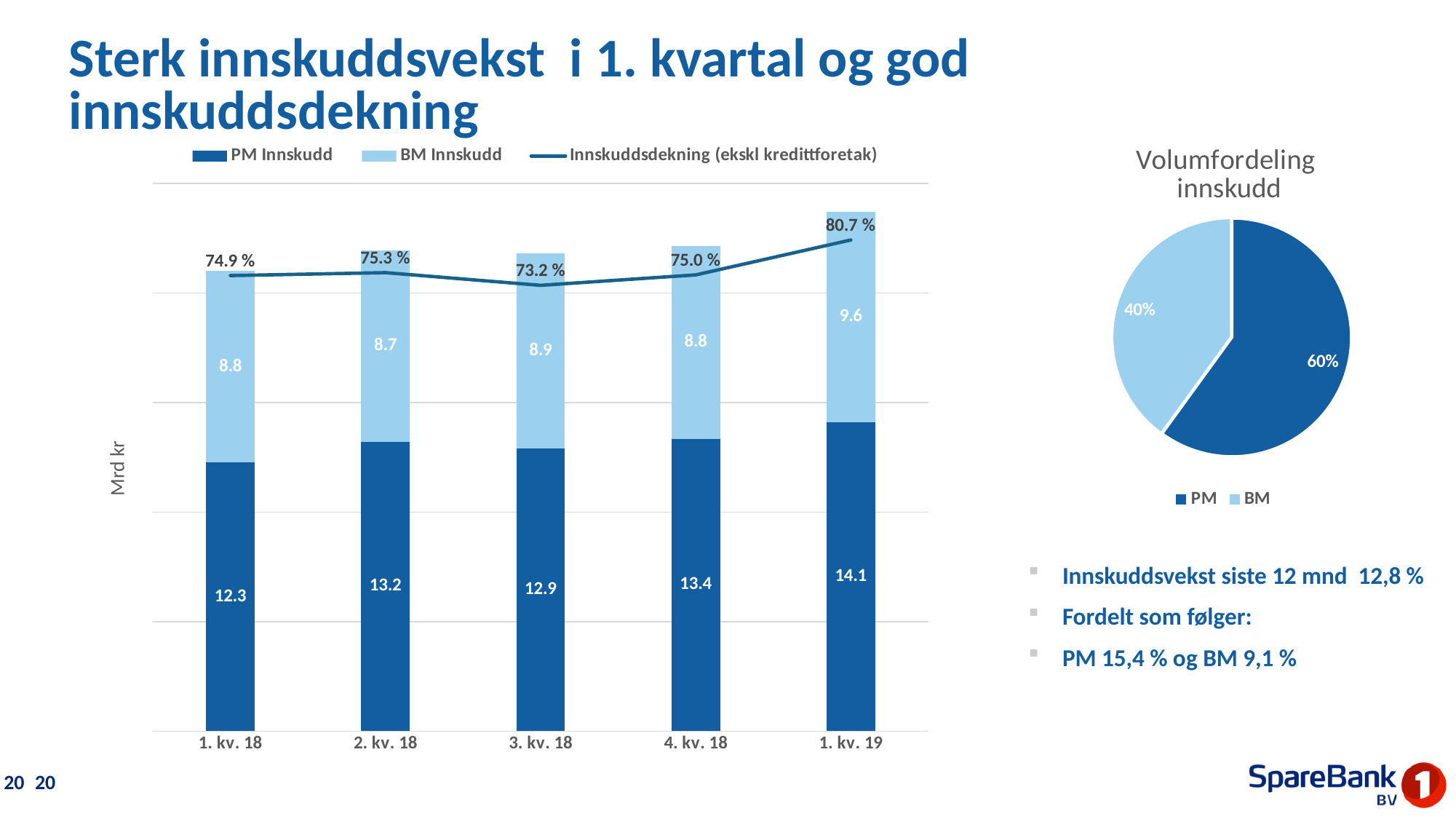
In the left bar chart, what is the PM Innskudd value for 1. kv. 19? 14.1 In the left chart, what is the Innskuddsdekning (ekskl kredittforetak) value for 1. kv. 19? 80.7 % In the left bar chart, what is the BM Innskudd value for 3. kv. 18? 8.9 How many quarters are shown on the x axis of the left bar chart? 5 In the pie chart titled Volumfordeling innskudd, what share does PM have? 60% What kind of chart is the chart titled Volumfordeling innskudd? pie chart In the left bar chart, what is the difference between the PM Innskudd values for 1. kv. 19 and 1. kv. 18? 1.8 How many series does the legend of the left chart list? 3 In the left chart, which quarter has the lowest Innskuddsdekning (ekskl kredittforetak) value? 3. kv. 18 In the left bar chart, is the PM Innskudd value for 2. kv. 18 larger or smaller than the PM Innskudd value for 3. kv. 18? larger In the left bar chart, which quarter has the highest PM Innskudd value? 1. kv. 19 In the left bar chart, what is the total of the stacked bar for 1. kv. 19? 23.7